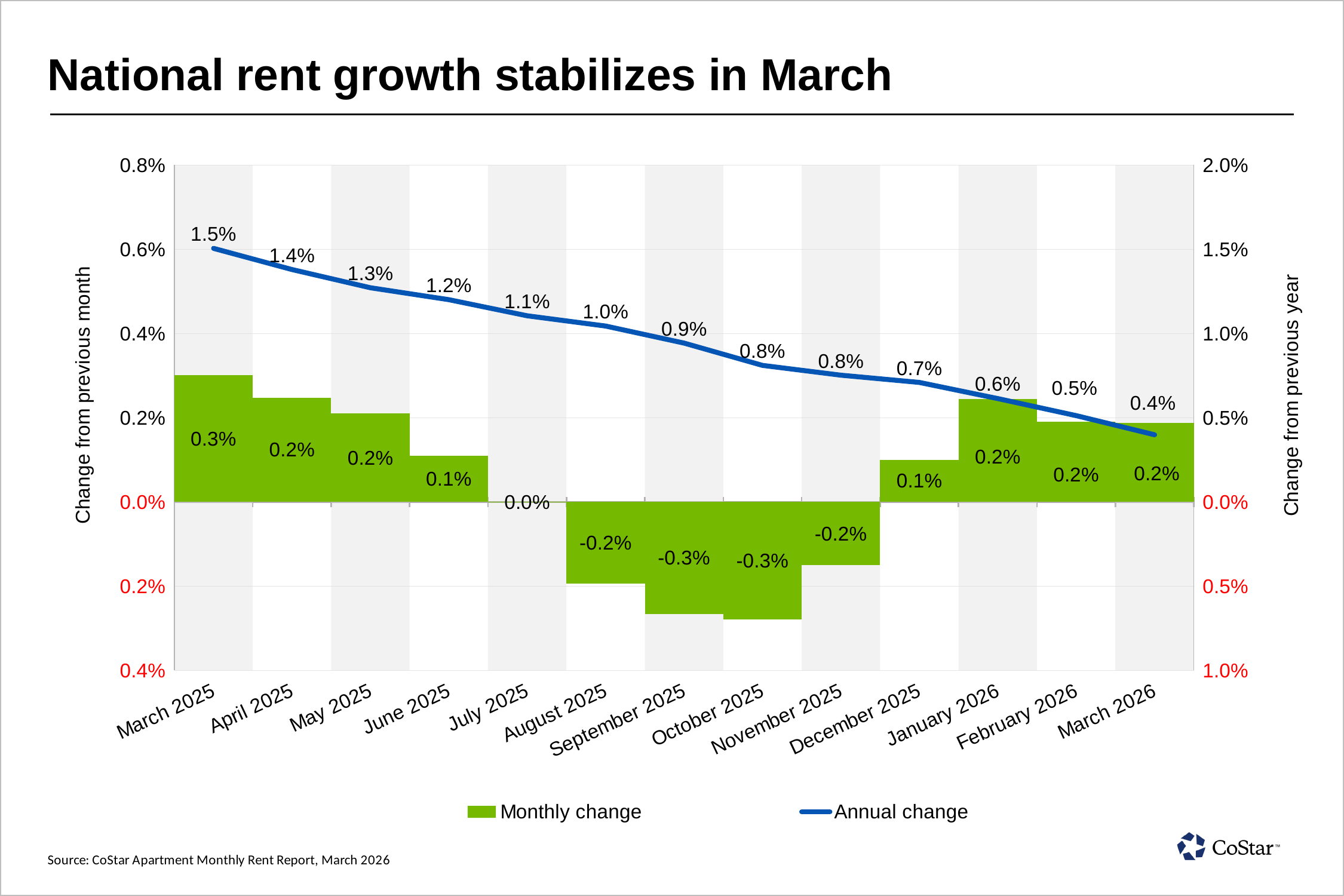
What is the difference between the annual change in March 2025 and the annual change in March 2026? 1.1 percentage points In which month is the annual change lowest? March 2026 What is the monthly change for March 2025? 0.3% How many series does the legend list? 2 What is the monthly change for September 2025? -0.3% What is the annual change for March 2026? 0.4% In which month is the annual change highest? March 2025 How many months are shown on the x axis? 13 What kind of chart is this? A combined bar and line chart Which is larger, the monthly change for March 2025 or the monthly change for June 2025? March 2025 What is the annual change for October 2025? 0.8% Does the annual change rise or fall from March 2025 to March 2026? Fall